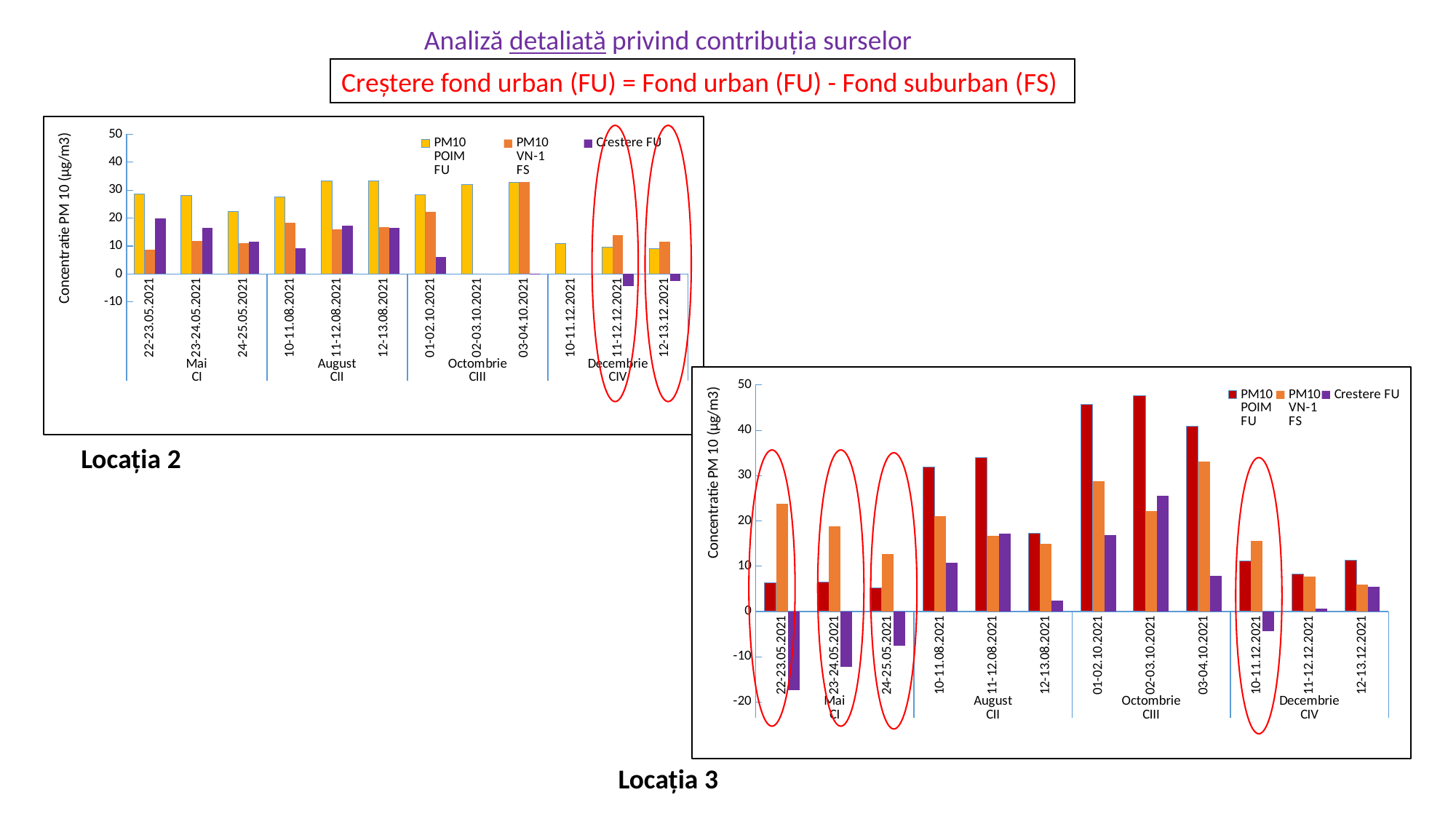
In the Locația 2 chart, is the PM10 POIM FU value for 22-23.05.2021 greater or less than 20? greater How many date categories are shown on the x axis of the Locația 3 chart? 12 In the Locația 3 chart, which date has the lowest Crestere FU value? 22-23.05.2021 In the Locația 2 chart, for 01-02.10.2021, which is larger: PM10 POIM FU or PM10 VN-1 FS? PM10 POIM FU What kind of chart is the Locația 2 chart? bar chart In the Locația 2 chart, which date has the highest Crestere FU value? 22-23.05.2021 In the Locația 3 chart, for 22-23.05.2021, which is larger: PM10 POIM FU or PM10 VN-1 FS? PM10 VN-1 FS In the Locația 3 chart, is the PM10 POIM FU value for 01-02.10.2021 greater or less than 40? greater What is the y-axis label of the Locația 3 chart? Concentratie PM 10 (µg/m3) In the Locația 3 chart, which date has the highest Crestere FU value? 02-03.10.2021 In the Locația 3 chart, is the Crestere FU value for 22-23.05.2021 greater or less than -10? less How many series does the legend of the Locația 3 chart list? 3